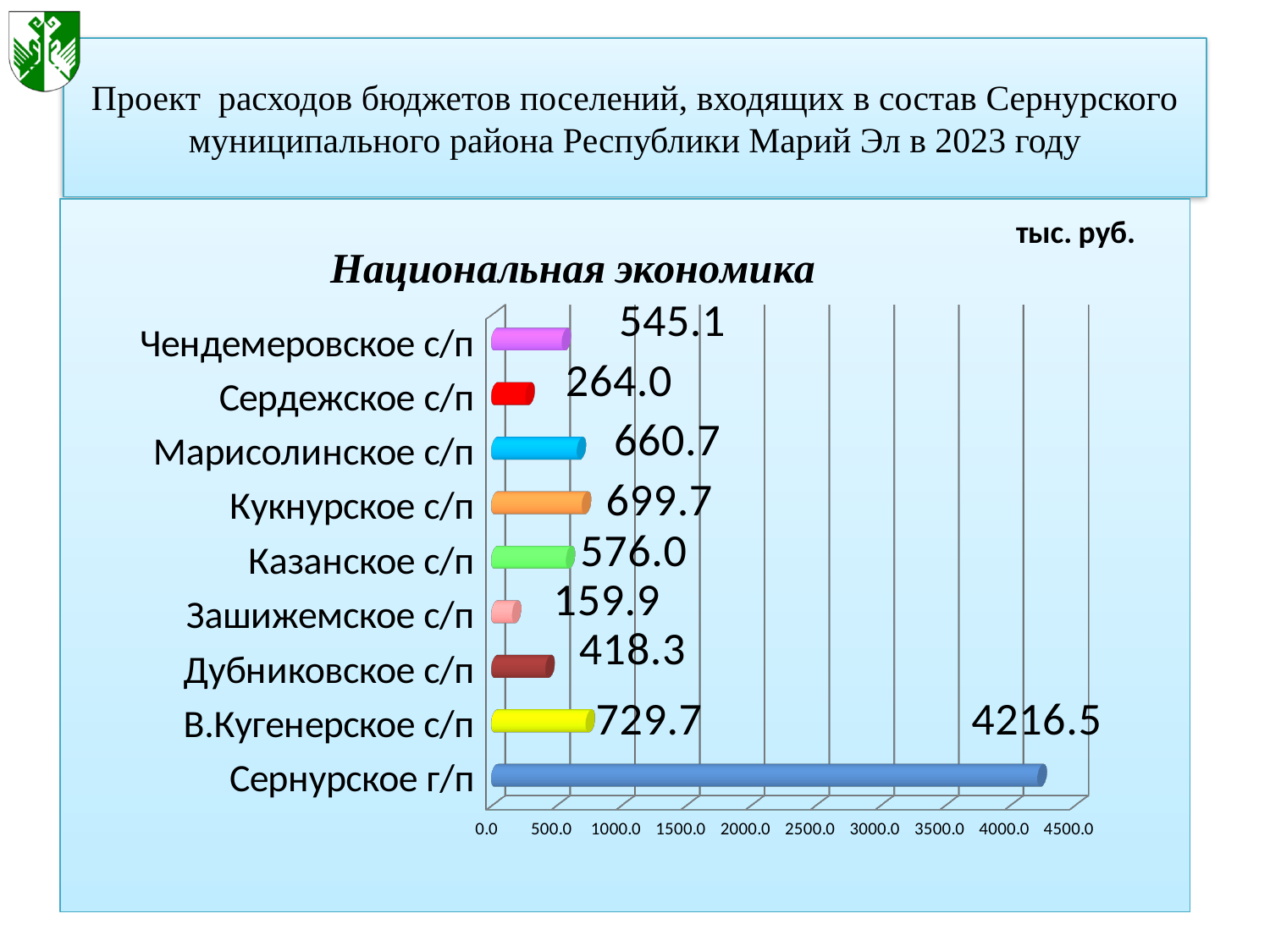
What is the difference between the values for Сернурское г/п and В.Кугенерское с/п? 3486.8 What is the value for Зашижемское с/п? 159.9 Which category has the lowest value? Зашижемское с/п Which is larger, the value for Кукнурское с/п or Марисолинское с/п? Кукнурское с/п What kind of chart is shown on the slide? bar chart Is the value for Дубниковское с/п greater or less than 500.0? less How many categories are shown in the chart? 9 What is the value for Сернурское г/п? 4216.5 Which category has the highest value? Сернурское г/п What is the value for Кукнурское с/п? 699.7 What is the title of the chart? Национальная экономика What is the difference between the values for Чендемеровское с/п and Сердежское с/п? 281.1